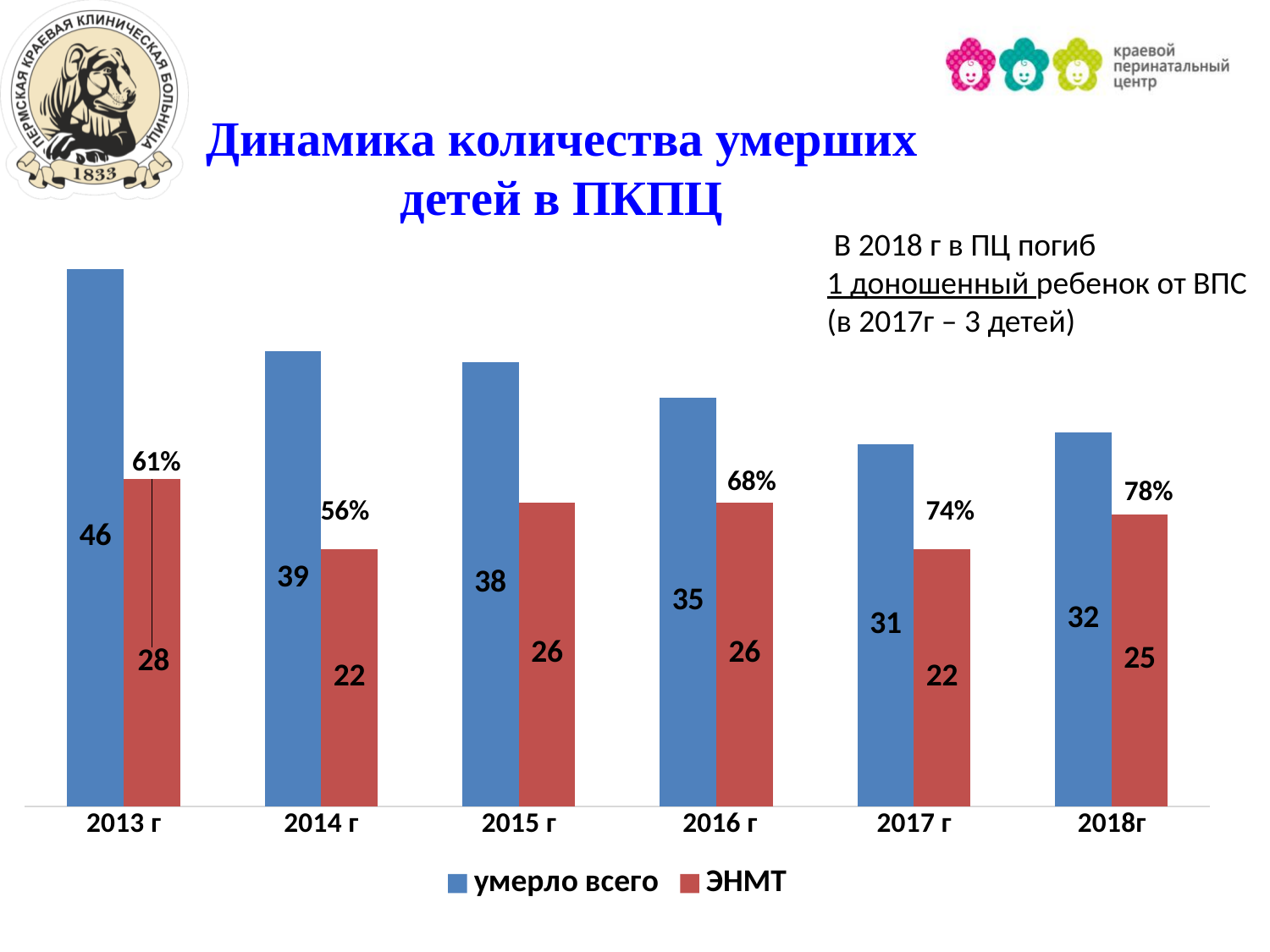
How many years are shown on the x axis? 6 Which is larger: the "ЭНМТ" value in 2013 г or in 2018г? 2013 г Which year has the lowest value for "умерло всего"? 2017 г What is the value for "умерло всего" in 2018г? 32 What percentage is shown above the "ЭНМТ" bar for 2017 г? 74% What is the value for "умерло всего" in 2013 г? 46 What is the difference between "умерло всего" and "ЭНМТ" in 2014 г? 17 What is the value for "ЭНМТ" in 2016 г? 26 How many series does the legend list? 2 Does the "умерло всего" series generally rise or fall from 2013 г to 2017 г? fall What kind of chart is shown on the slide? bar chart Which year has the highest value for "умерло всего"? 2013 г